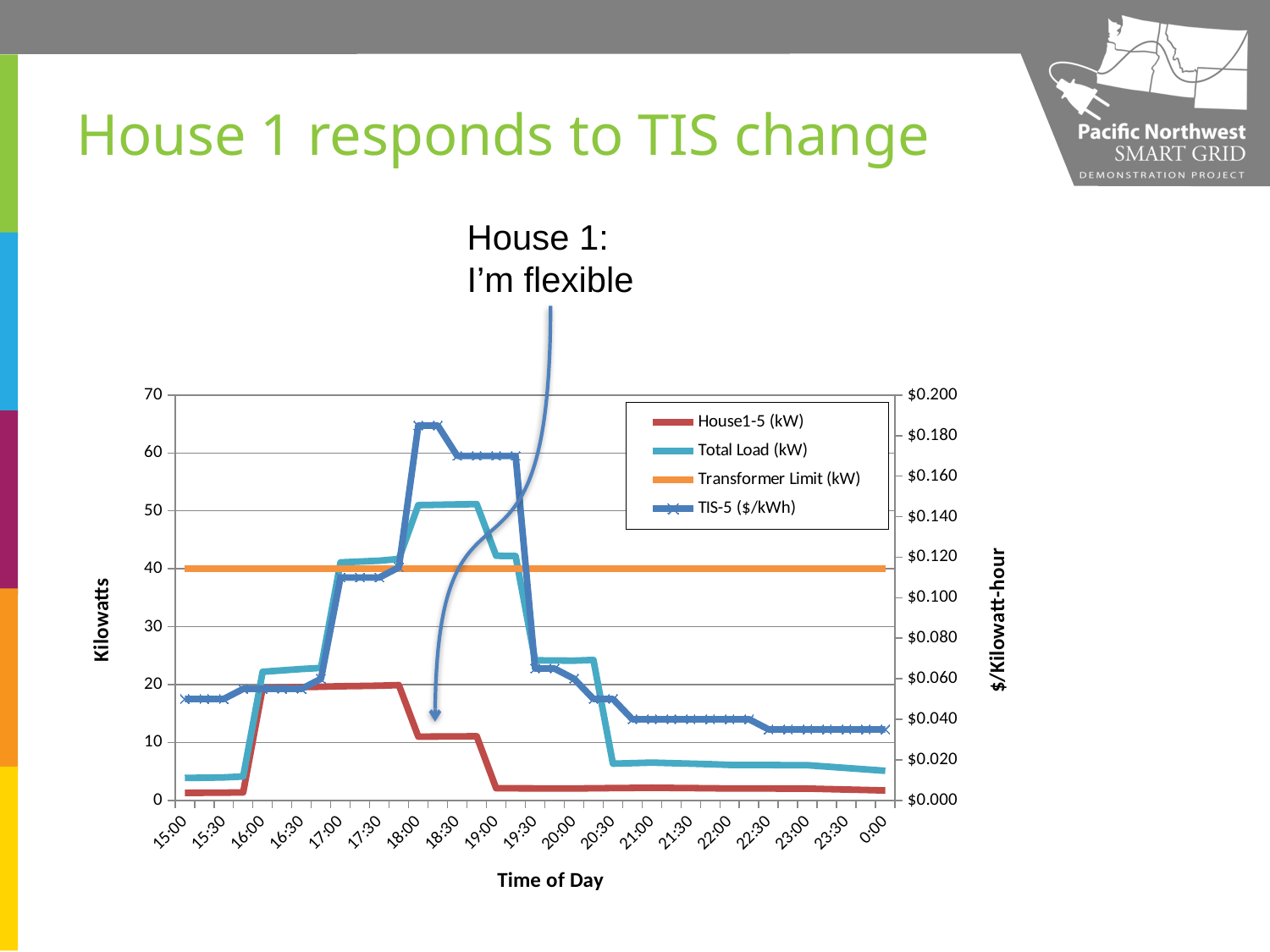
Is the Total Load (kW) value at 18:00 greater or less than 40? greater Is the Total Load (kW) value at 21:00 greater or less than 10? less At 18:00, which is larger: Total Load (kW) or Transformer Limit (kW)? Total Load (kW) What kind of chart is shown on the slide? line chart What is the title of the x axis? Time of Day How many time labels are shown on the x axis? 19 Is the TIS-5 ($/kWh) value at 23:00 greater or less than $0.060? less Does the Total Load (kW) series rise or fall between 19:30 and 0:00? fall What is the value of the Transformer Limit (kW) series? 40 How many series does the chart legend list? 4